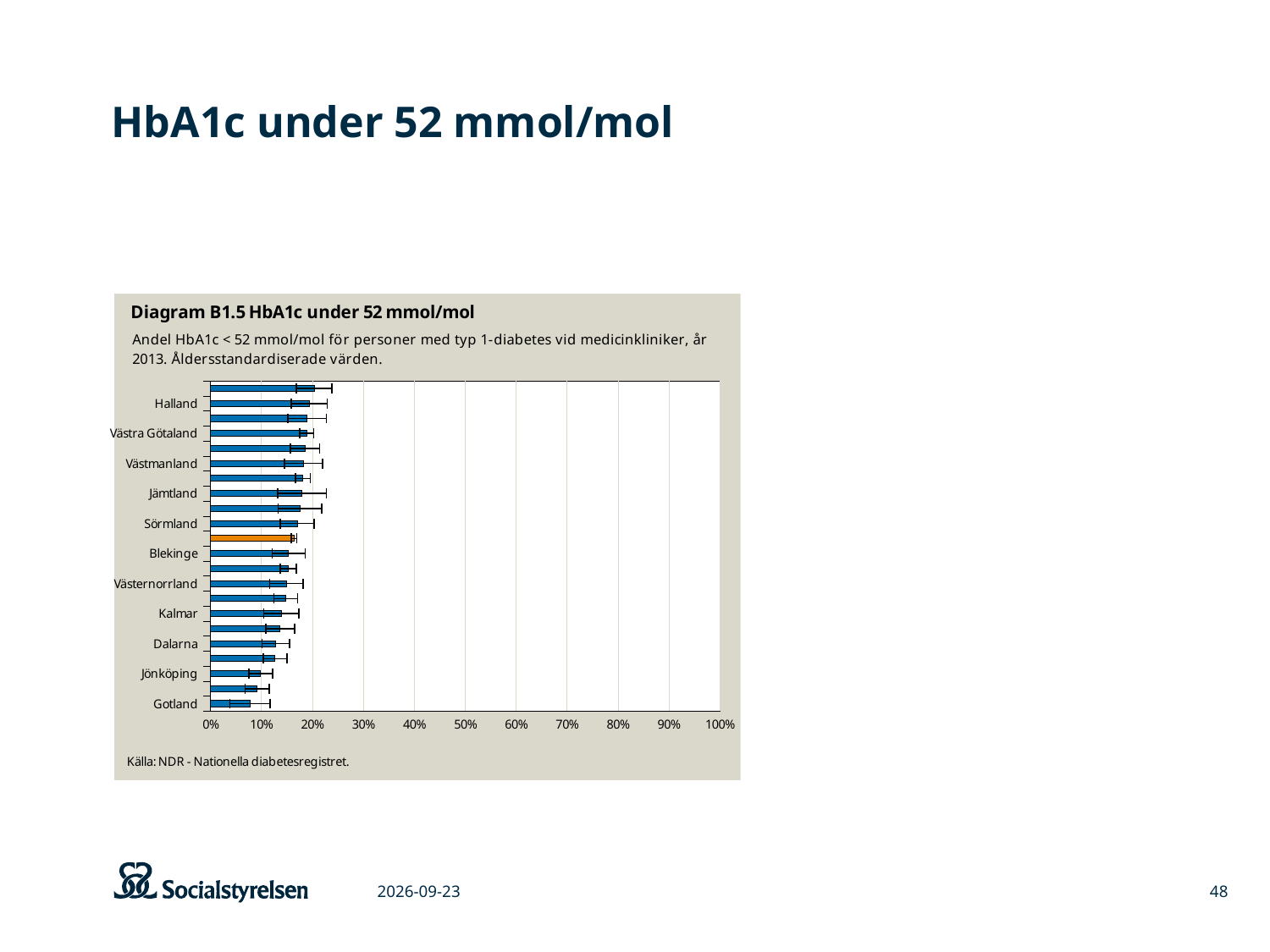
Which has the larger value, Västmanland or Dalarna? Västmanland Is the value for Västra Götaland greater or less than 30%? less What is the title of the diagram shown on the slide? Diagram B1.5 HbA1c under 52 mmol/mol What source is cited below the chart? NDR - Nationella diabetesregistret Is the value for Kalmar greater or less than 10%? greater Do the bar values increase or decrease going from the top of the chart to the bottom? decrease Which has the larger value, Jämtland or Kalmar? Jämtland What kind of chart is shown on the slide? bar chart Is the value for Dalarna greater or less than 20%? less Which has the larger value, Halland or Gotland? Halland